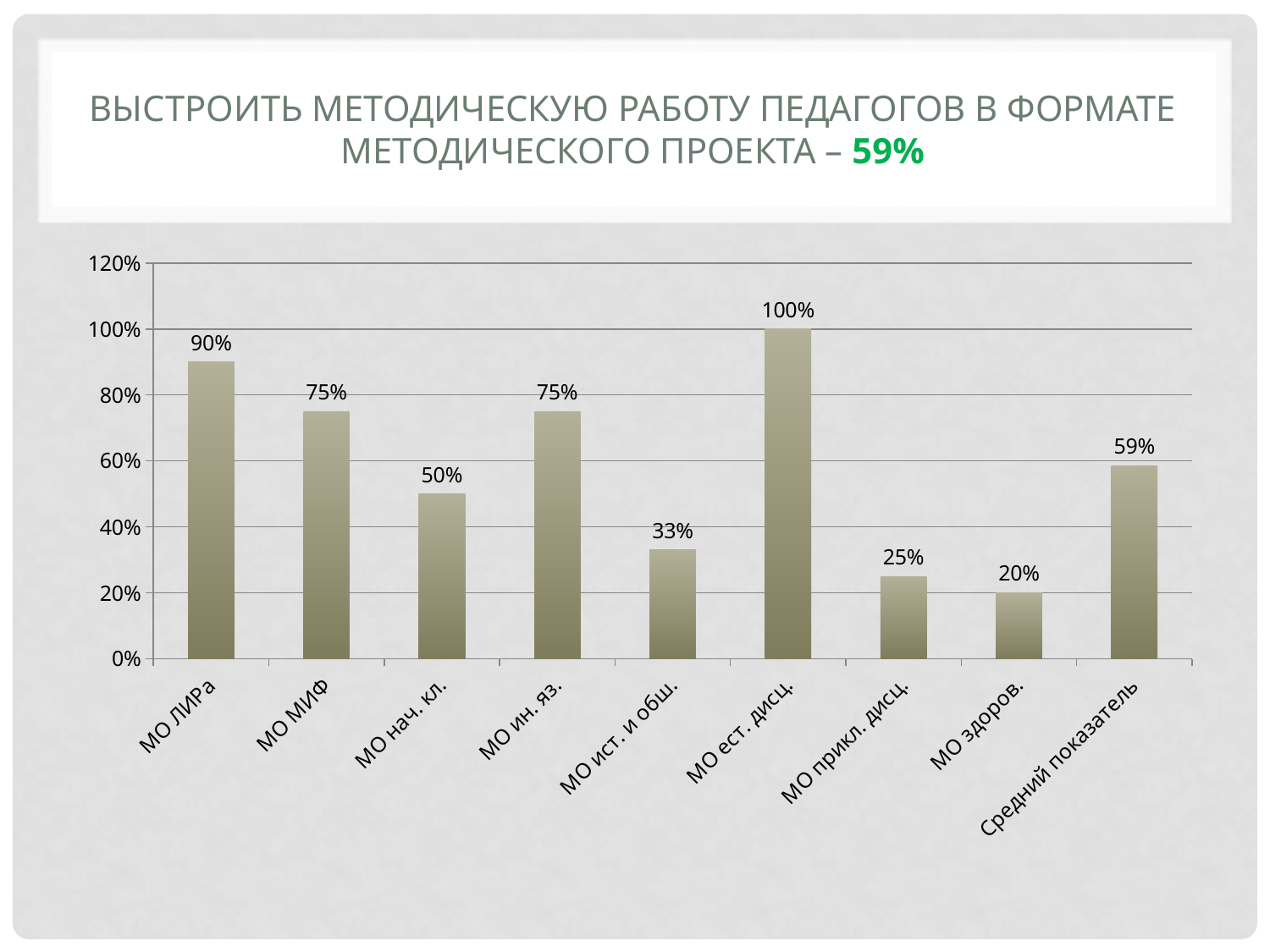
Which is larger, the value for МО прикл. дисц. or the value for МО здоров.? МО прикл. дисц. Is the value for МО ин. яз. greater or less than 60%? greater What is the difference between the values for МО ЛИРа and МО нач. кл.? 40% Which category has the highest value? МО ест. дисц. What is the value for МО ЛИРа? 90% What is the highest value shown on the vertical axis? 120% What kind of chart is shown on the slide? bar chart What is the difference between the values for МО ест. дисц. and Средний показатель? 41% How many categories are shown on the x axis? 9 What is the value for Средний показатель? 59% Which category has the lowest value? МО здоров. What is the value for МО ист. и общ.? 33%